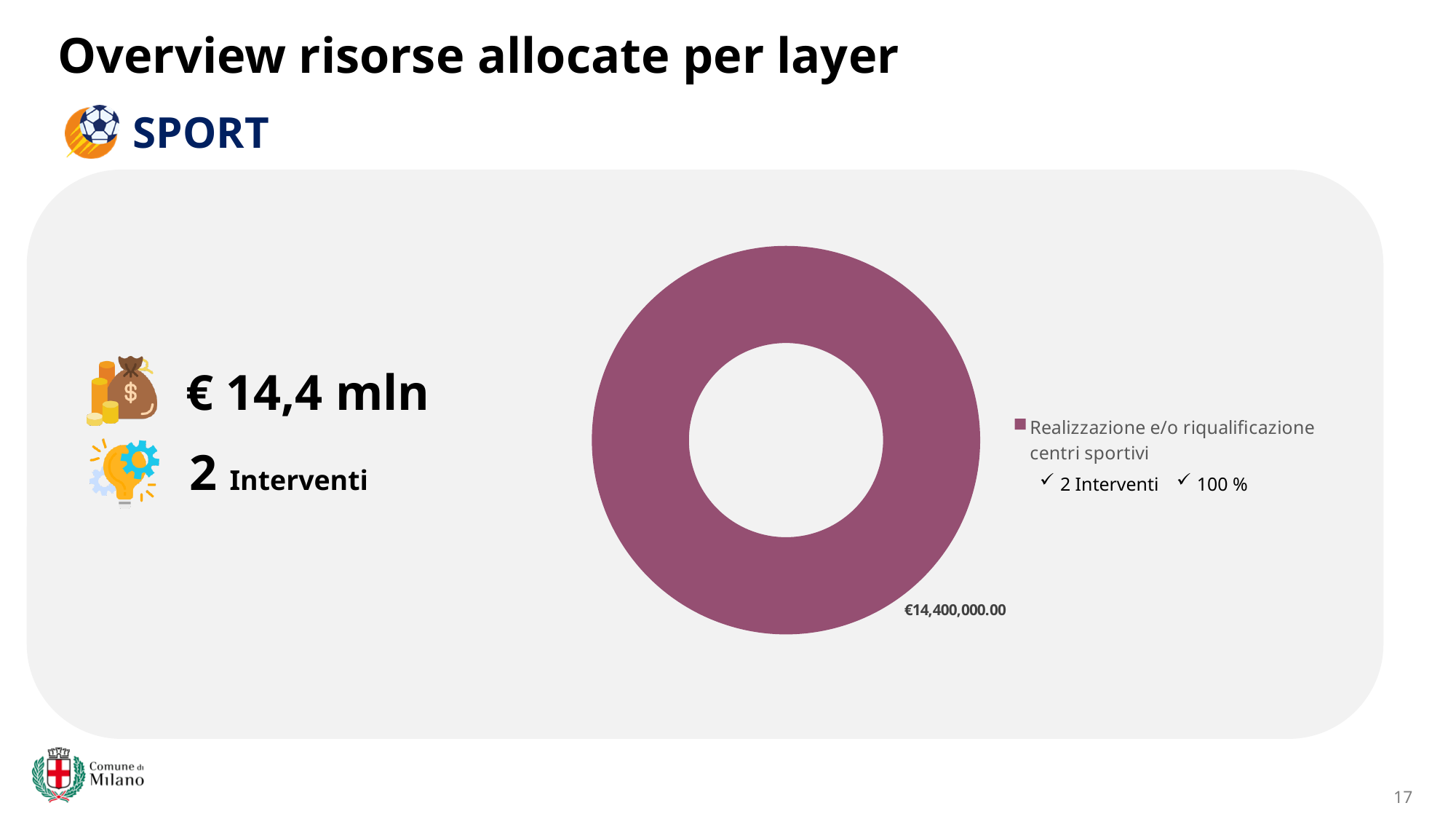
What share of the donut does "Realizzazione e/o riqualificazione centri sportivi" represent? 100 % What value is labelled on the slice for "Realizzazione e/o riqualificazione centri sportivi"? €14,400,000.00 What is the name of the only category shown in the chart legend? Realizzazione e/o riqualificazione centri sportivi How many entries does the chart legend list? 1 How many slices does the donut chart have? 1 What colour is the slice in the donut chart? Purple (mauve) How many "Interventi" are listed under the legend entry "Realizzazione e/o riqualificazione centri sportivi"? 2 Interventi What kind of chart is shown on the slide? Pie chart (donut) Which category is the largest in the donut chart? Realizzazione e/o riqualificazione centri sportivi